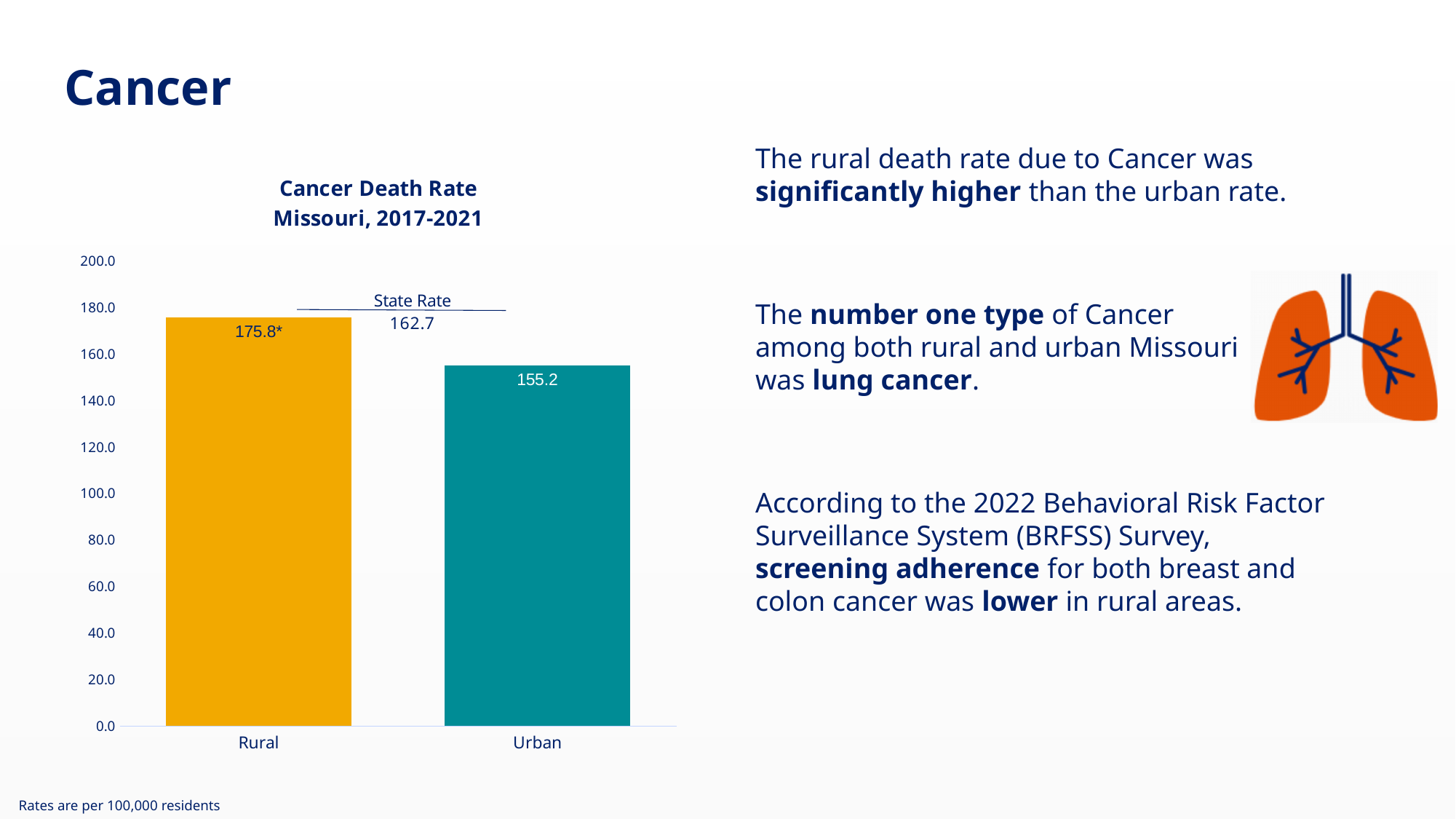
What is the cancer death rate for Urban in the chart? 155.2 What kind of chart is shown on the slide? Bar chart What colour is the Urban bar in the chart? Teal Which category has the higher cancer death rate, Rural or Urban? Rural What is the State Rate shown on the chart? 162.7 How many categories are shown on the x axis of the chart? 2 Which category has the lowest cancer death rate in the chart? Urban What is the title of the chart? Cancer Death Rate Missouri, 2017-2021 What is the difference between the Rural and Urban cancer death rates? 20.6 Is the Rural cancer death rate greater or less than 160.0? greater Is the Urban cancer death rate greater or less than 160.0? less What is the cancer death rate for Rural in the chart? 175.8*